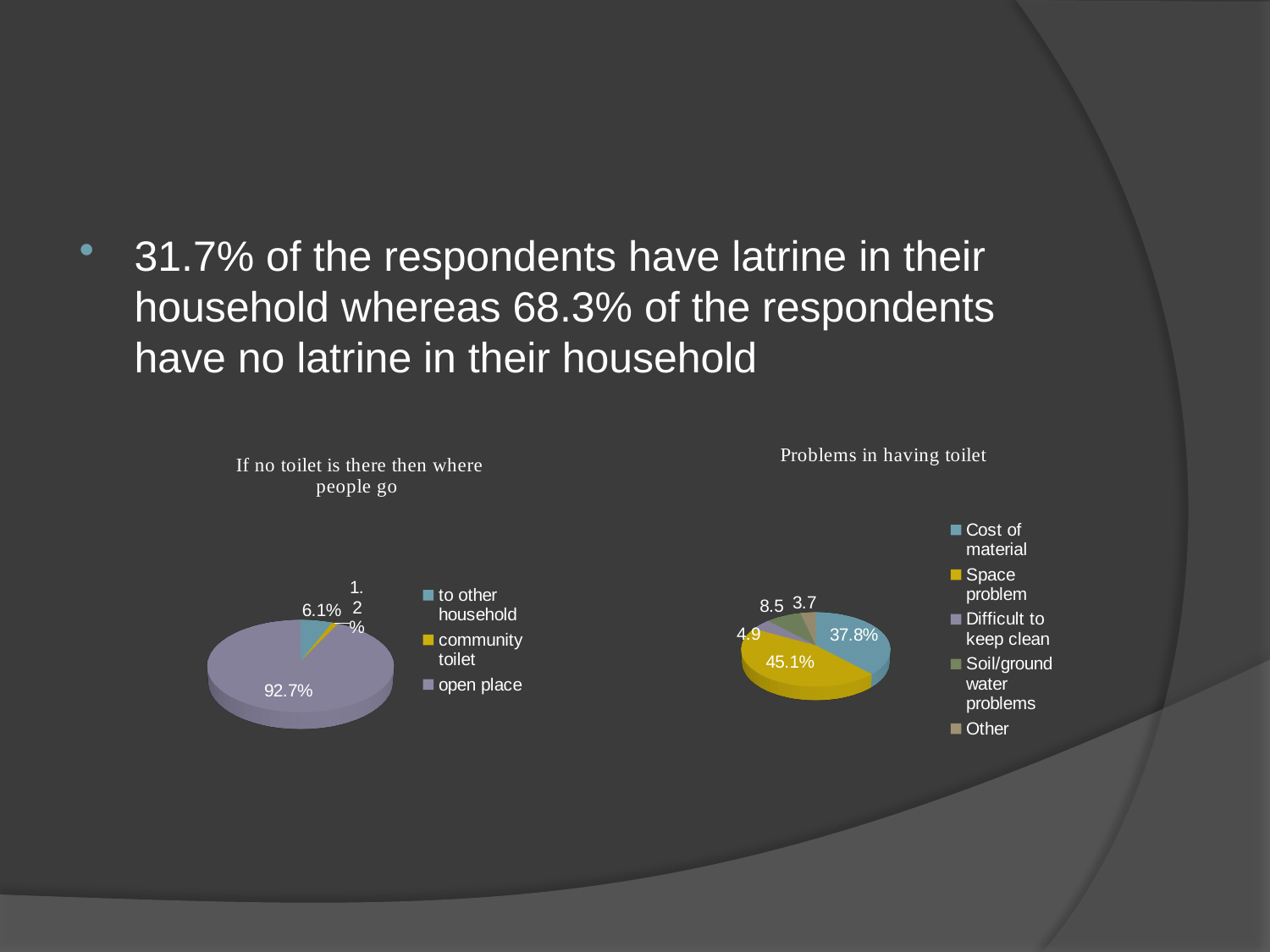
In the chart titled "Problems in having toilet", which is larger, Difficult to keep clean or Soil/ground water problems? Soil/ground water problems In the chart titled "If no toilet is there then where people go", how many categories does the legend list? 3 What kind of chart is the chart titled "Problems in having toilet"? pie chart In the chart titled "Problems in having toilet", what is the value for Cost of material? 37.8% In the chart titled "If no toilet is there then where people go", what is the value for open place? 92.7% In the chart titled "If no toilet is there then where people go", what is the value for to other household? 6.1% In the chart titled "Problems in having toilet", what is the value for Space problem? 45.1% In the chart titled "If no toilet is there then where people go", which category has the smallest share? community toilet In the chart titled "Problems in having toilet", what is the value for Soil/ground water problems? 8.5 In the chart titled "If no toilet is there then where people go", which category has the largest share? open place In the chart titled "Problems in having toilet", how many categories does the legend list? 5 In the chart titled "Problems in having toilet", which category has the largest share? Space problem